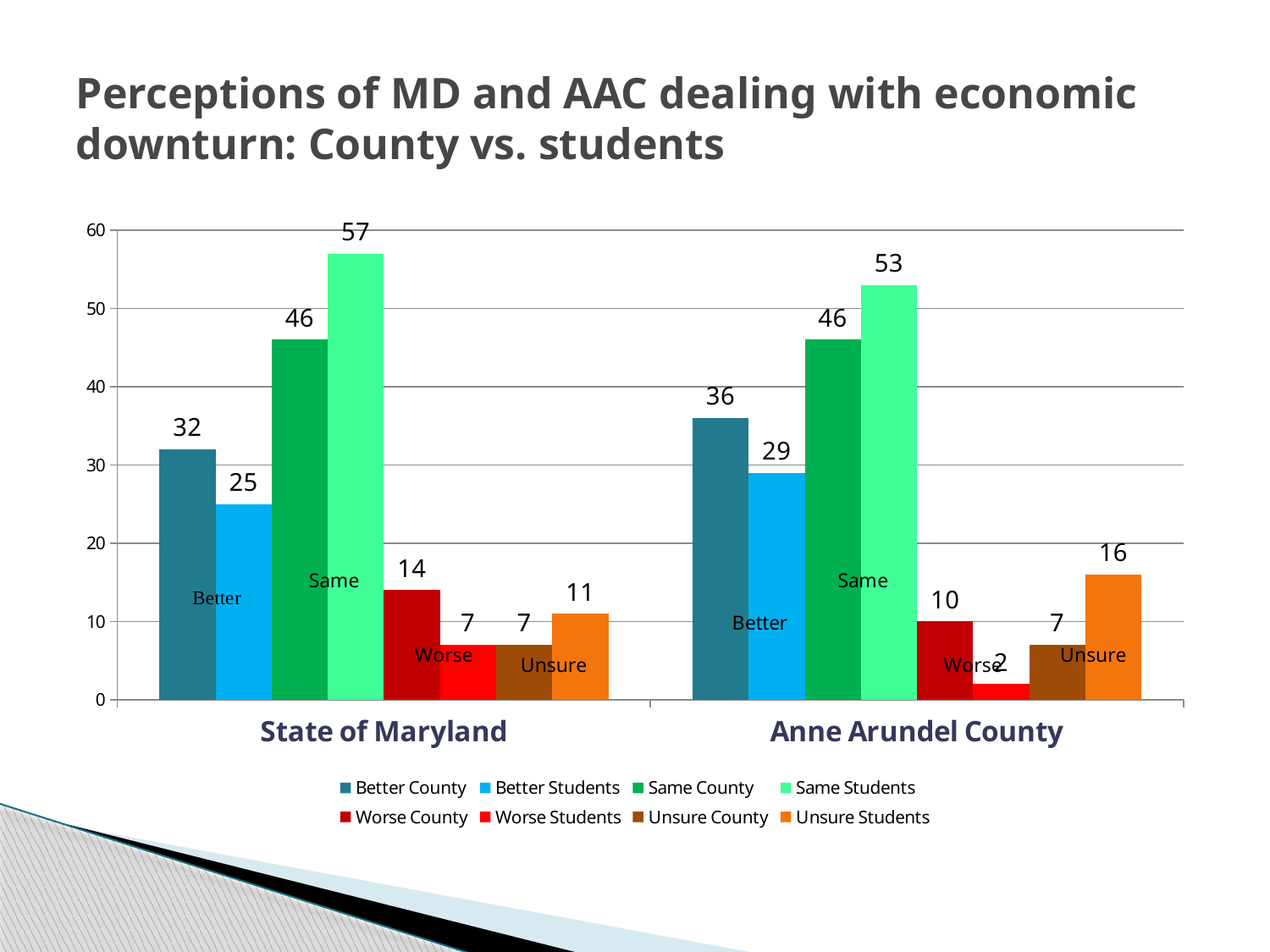
What is the value for Better County in the Anne Arundel County group? 36 What is the value for Same Students in the State of Maryland group? 57 Is the value for Worse County in the State of Maryland group greater or less than 10? greater How many category groups are shown on the x axis? 2 What kind of chart is shown on the slide? Bar chart Which series has the lowest value in the Anne Arundel County group? Worse Students Which is larger: Better County for the State of Maryland or Better County for Anne Arundel County? Better County for Anne Arundel County How many series does the legend list? 8 What is the value for Worse Students in the Anne Arundel County group? 2 What is the value for Unsure Students in the State of Maryland group? 11 What is the difference between Same Students and Same County in the State of Maryland group? 11 Which series has the highest value in the Anne Arundel County group? Same Students